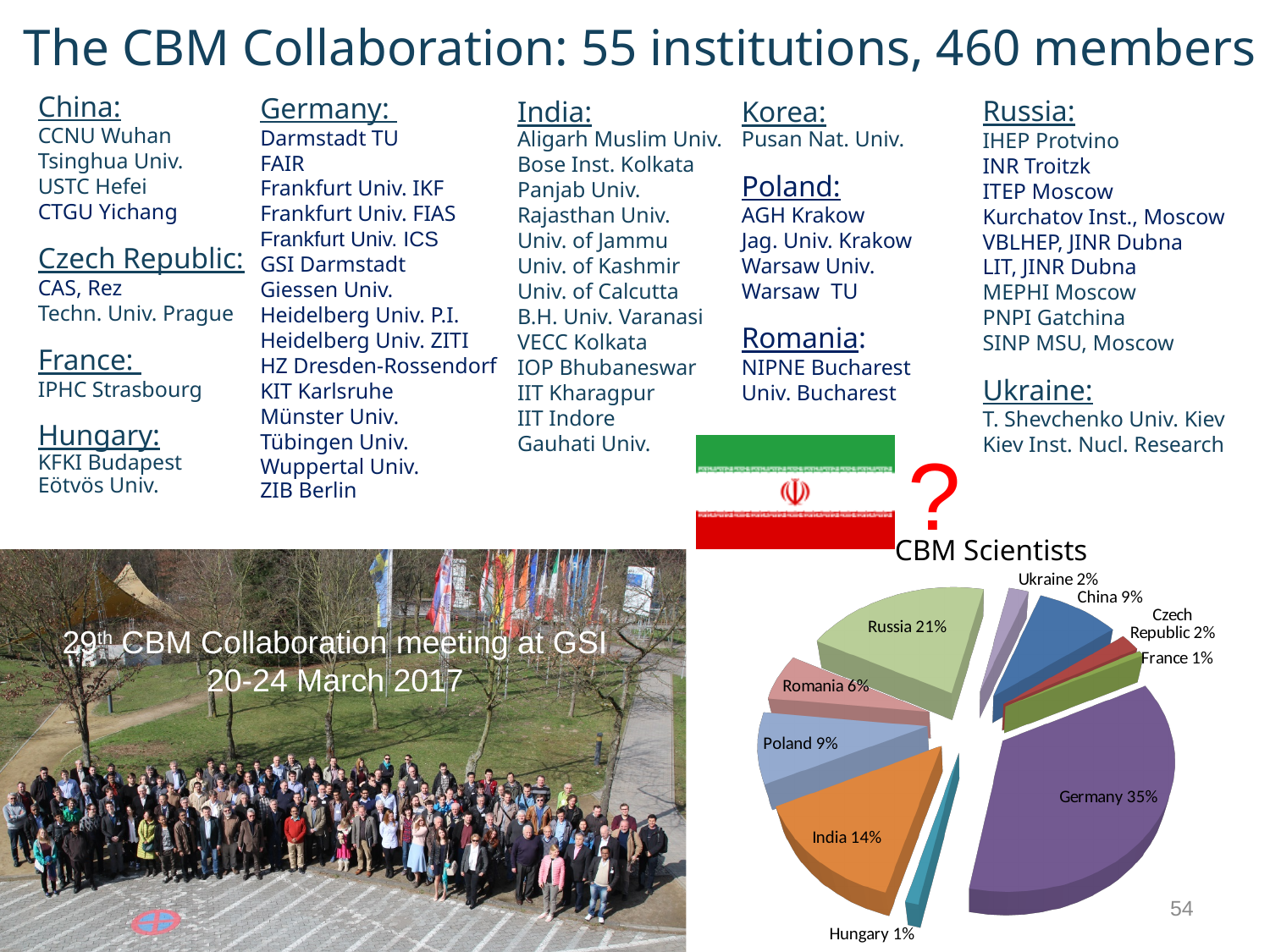
What is the title of the pie chart on the slide? CBM Scientists In the CBM Scientists pie chart, which two countries each have a share of 1%? France and Hungary How many slices are labelled in the CBM Scientists pie chart? 10 In the CBM Scientists pie chart, what is the combined share of Poland and China? 18% What kind of chart is shown under the title "CBM Scientists"? pie chart In the CBM Scientists pie chart, which is larger, the share for Russia or the share for India? Russia In the CBM Scientists pie chart, what is the difference between Germany's share and Russia's share? 14% In the CBM Scientists pie chart, what share does Romania have? 6% Which country has the largest slice in the CBM Scientists pie chart? Germany In the CBM Scientists pie chart, what share does India have? 14% In the CBM Scientists pie chart, what share does Germany have? 35% In the CBM Scientists pie chart, what share does Russia have? 21%